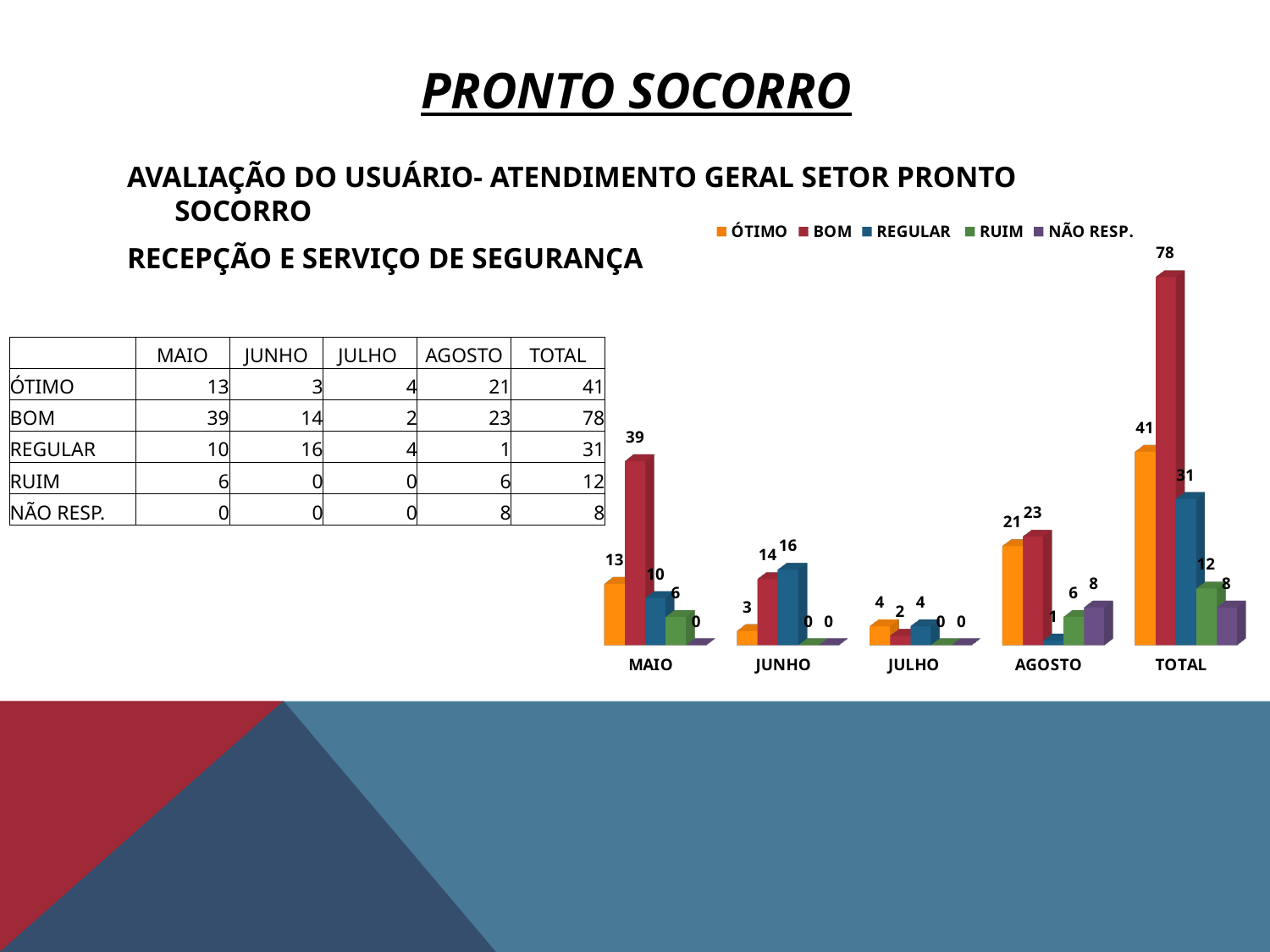
How many series does the legend list? 5 What kind of chart is shown? bar chart Which category has the lowest value for BOM? JULHO How many categories are shown on the x axis? 5 What is the value for REGULAR in JUNHO? 16 Which is larger in JUNHO, BOM or REGULAR? REGULAR What is the difference between BOM and ÓTIMO in TOTAL? 37 Which series has the highest value in the TOTAL category? BOM What is the value for NÃO RESP. in TOTAL? 8 Which colour represents the RUIM series in the legend? green What is the value for BOM in MAIO? 39 What is the value for ÓTIMO in AGOSTO? 21